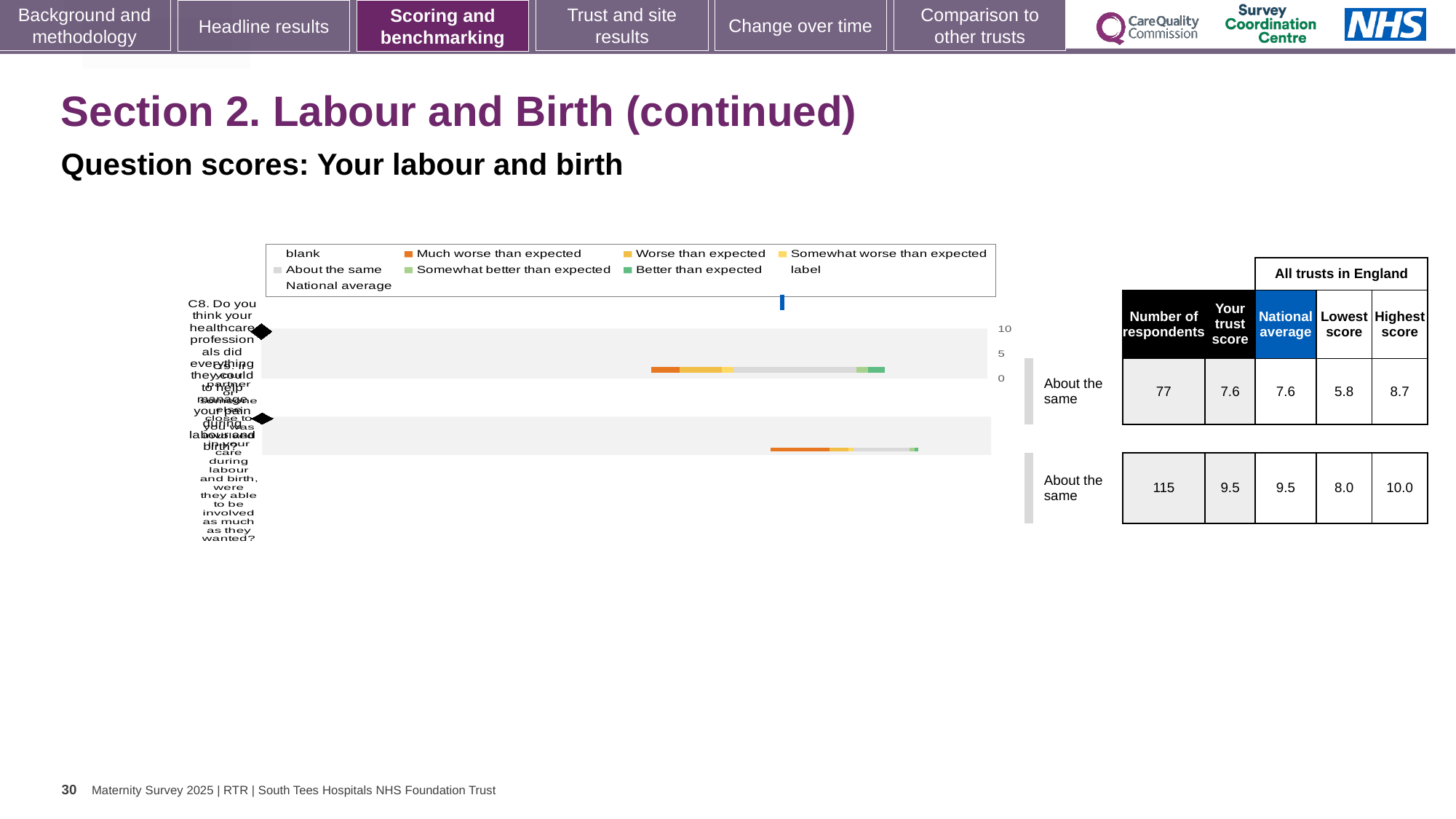
What is the highest tick value shown on the chart's score axis? 10 In the table next to the chart, what is the highest score across all trusts in England for the first question (C8)? 8.7 In the table next to the chart, how many respondents are listed for the second question? 115 Which of the two questions has the larger number of respondents in the table next to the chart? the second question (115) In the table next to the chart, what is the difference between the highest and lowest scores for the first question (C8)? 2.9 How many bars (questions) are plotted in the chart? 2 In the table next to the chart, what is the lowest score across all trusts in England for the second question? 8.0 How many entries does the chart legend list? 9 In the table next to the chart, what is the trust score for the first question (C8)? 7.6 What colour is used for 'Much worse than expected' in the legend? orange In the table next to the chart, how many respondents are listed for the first question (C8)? 77 What kind of chart is shown on the slide? bar chart